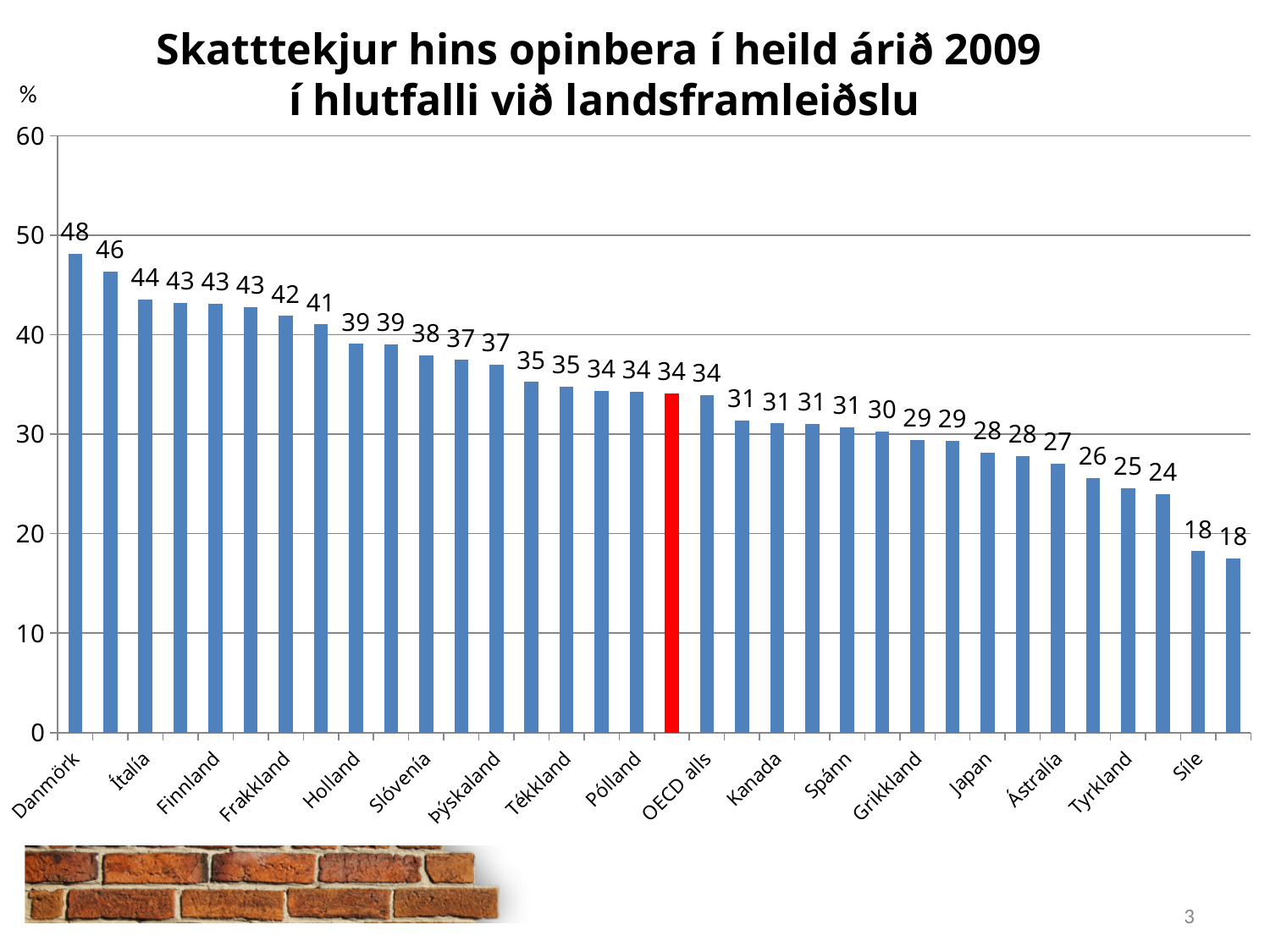
Do the values rise or fall from left to right along the x axis? fall What is the value for OECD alls? 34 What is the value for Danmörk? 48 What is the value for Þýskaland? 37 What is the difference between the values for Danmörk and Ítalía? 4 What is the value for Frakkland? 42 Which category has the highest value? Danmörk Is the value for Tyrkland greater or less than 30? less What is the value for Síle? 18 Which is larger, the value for Finnland or the value for Holland? Finnland What kind of chart is shown on the slide? bar chart What is the value for Ítalía? 44